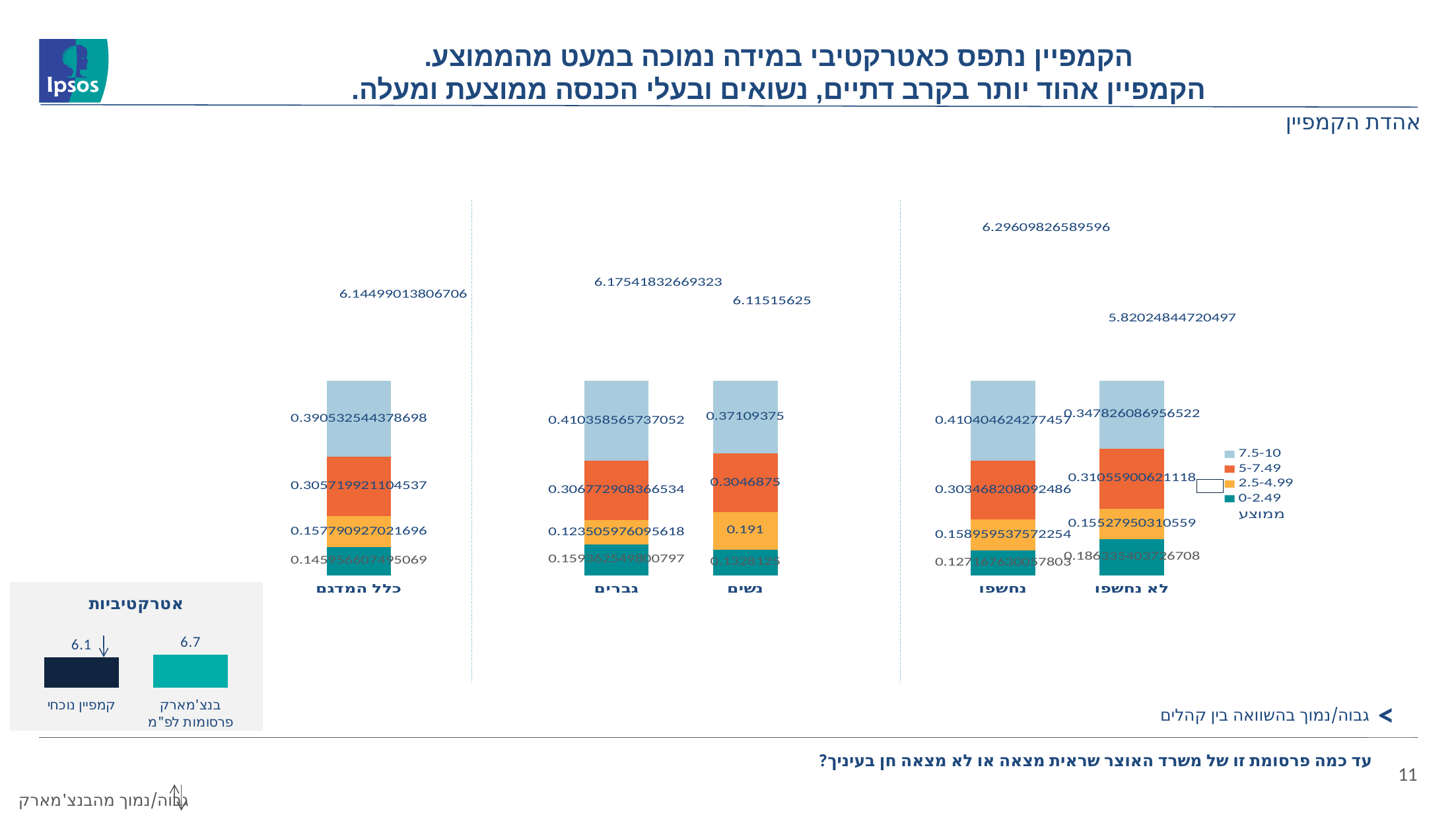
In the main stacked bar chart, what is the 7.5-10 share for גברים? 0.410358565737052 What kind of chart is the main chart on the slide? Stacked bar chart In the main stacked bar chart, what is the 5-7.49 share for לא נחשפו? 0.31055900621118 In the main stacked bar chart, what is the 2.5-4.99 share for נשים? 0.191 In the small אטרקטיביות chart at the bottom left, what is the difference between the בנצ'מארק value and the קמפיין נוכחי value? 0.6 How many categories are shown on the x axis of the main stacked bar chart? 5 In the small אטרקטיביות chart at the bottom left, what is the value for קמפיין נוכחי? 6.1 In the main stacked bar chart, which category has the lowest average (ממוצע) value? לא נחשפו In the main stacked bar chart, which has a larger 7.5-10 share: נחשפו or לא נחשפו? נחשפו In the main stacked bar chart, what is the average (ממוצע) value shown for כלל המדגם? 6.14499013806706 How many entries does the legend of the main stacked bar chart list? 5 In the main stacked bar chart, which category has the highest average (ממוצע) value? נחשפו